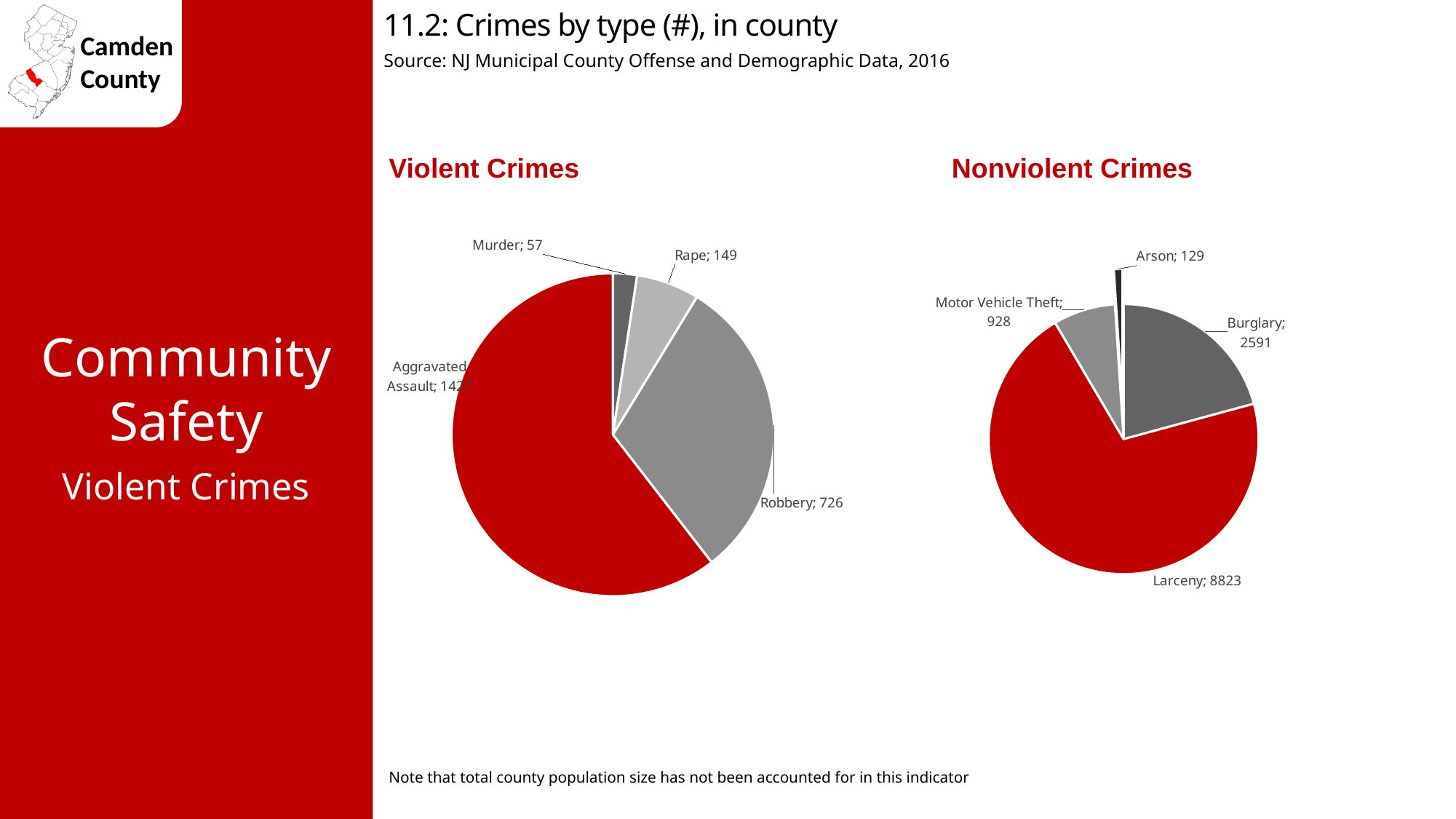
In the Nonviolent Crimes pie chart, what is the difference between Burglary and Motor Vehicle Theft? 1663 In the Violent Crimes pie chart, which crime type has the smallest slice? Murder In the Nonviolent Crimes pie chart, which is larger, Motor Vehicle Theft or Arson? Motor Vehicle Theft What kind of chart is used for Violent Crimes on this slide? Pie chart In the Violent Crimes pie chart, what is the difference between Robbery and Rape? 577 How many crime types are shown in the Nonviolent Crimes pie chart? 4 In the Violent Crimes pie chart, how many murders are shown? 57 In the Nonviolent Crimes pie chart, which crime type has the smallest value? Arson In the Nonviolent Crimes pie chart, what is the value for Larceny? 8823 In the Nonviolent Crimes pie chart, what is the value for Burglary? 2591 In the Violent Crimes pie chart, what is the value for Robbery? 726 In the Violent Crimes pie chart, which crime type has the largest slice? Aggravated Assault